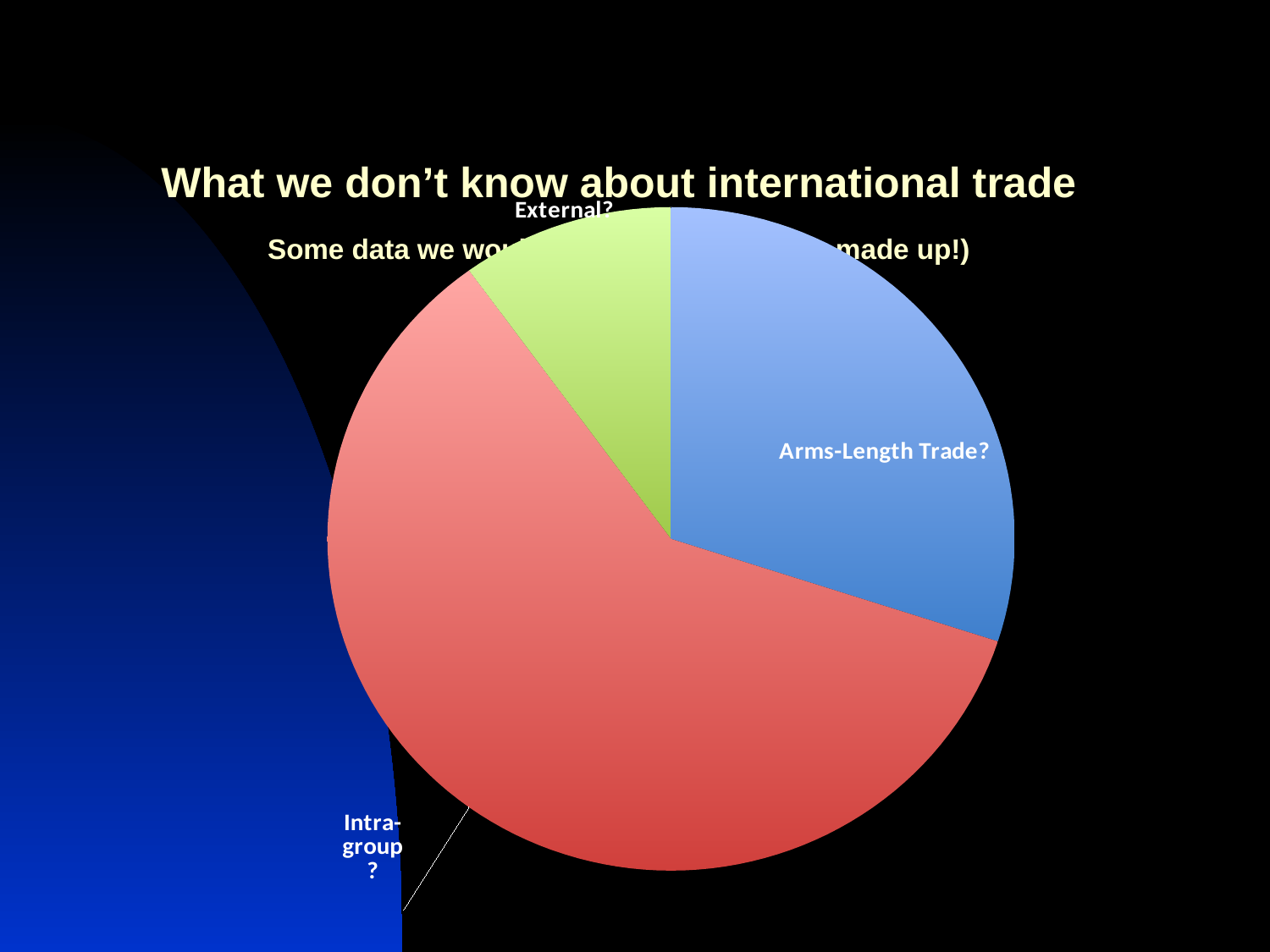
Which slice of the pie chart is the smallest? External? What kind of chart is shown on the slide? pie chart What colour is the External? slice? green Which slice is larger, Arms-Length Trade? or External? Arms-Length Trade? How many slices does the pie chart have? 3 Does the Intra-group? slice take up more or less than half of the pie? more Which slice of the pie chart is the largest? Intra-group? What colour is the Arms-Length Trade? slice? blue Which slice is larger, Intra-group? or Arms-Length Trade? Intra-group?